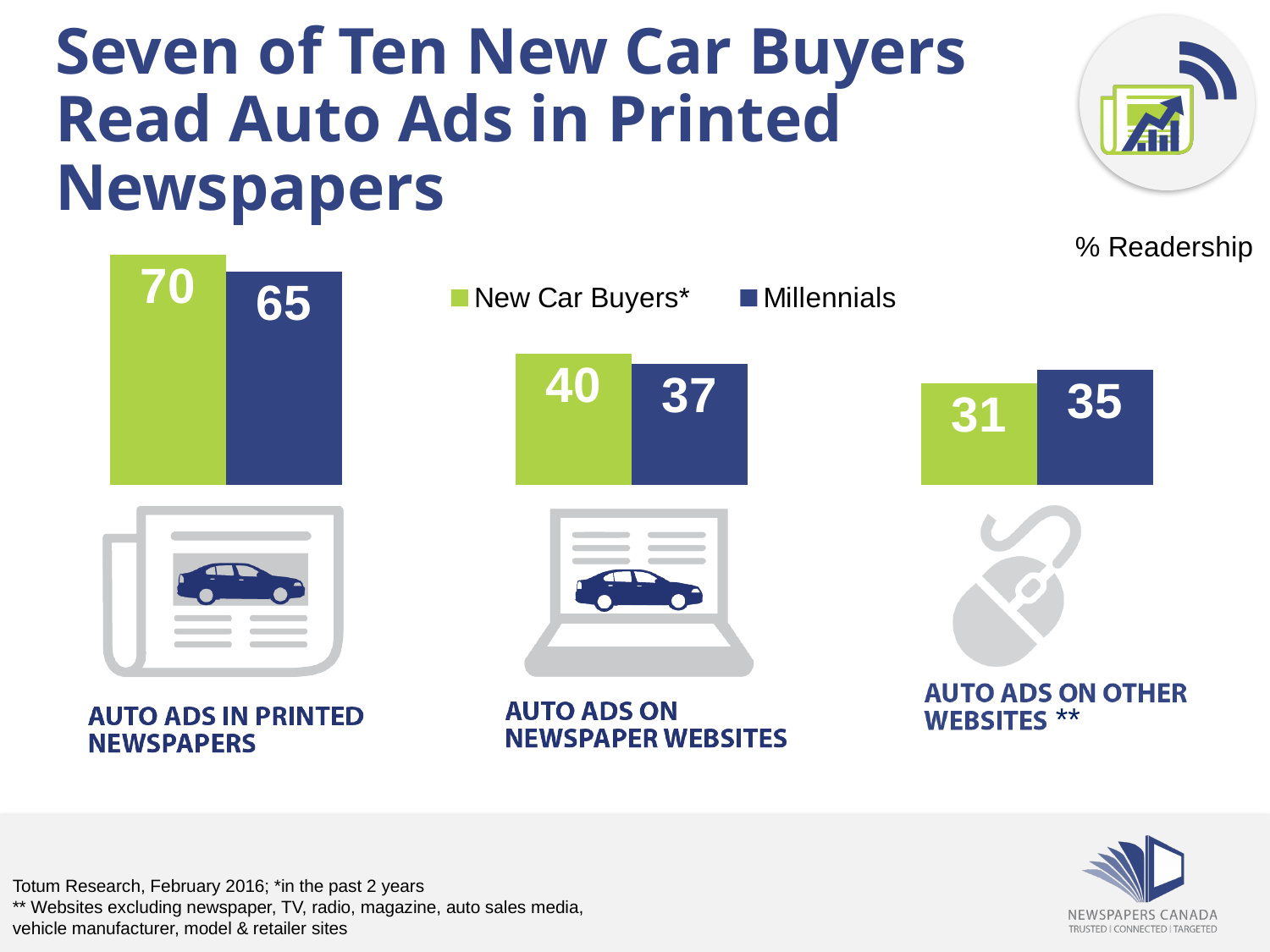
What is the value for Millennials for Auto Ads on Newspaper Websites? 37 What is the value for Millennials for Auto Ads in Printed Newspapers? 65 Which category has the highest value for New Car Buyers? Auto Ads in Printed Newspapers Which category has the lowest value for Millennials? Auto Ads on Other Websites What is the difference between New Car Buyers and Millennials for Auto Ads in Printed Newspapers? 5 Which colour represents Millennials in the chart? Dark blue How many categories are shown in the chart? 3 For Auto Ads on Other Websites, which is larger: New Car Buyers or Millennials? Millennials What is the value for New Car Buyers for Auto Ads on Other Websites? 31 What kind of chart is shown on the slide? Bar chart How many series does the legend list? 2 What is the value for New Car Buyers for Auto Ads in Printed Newspapers? 70